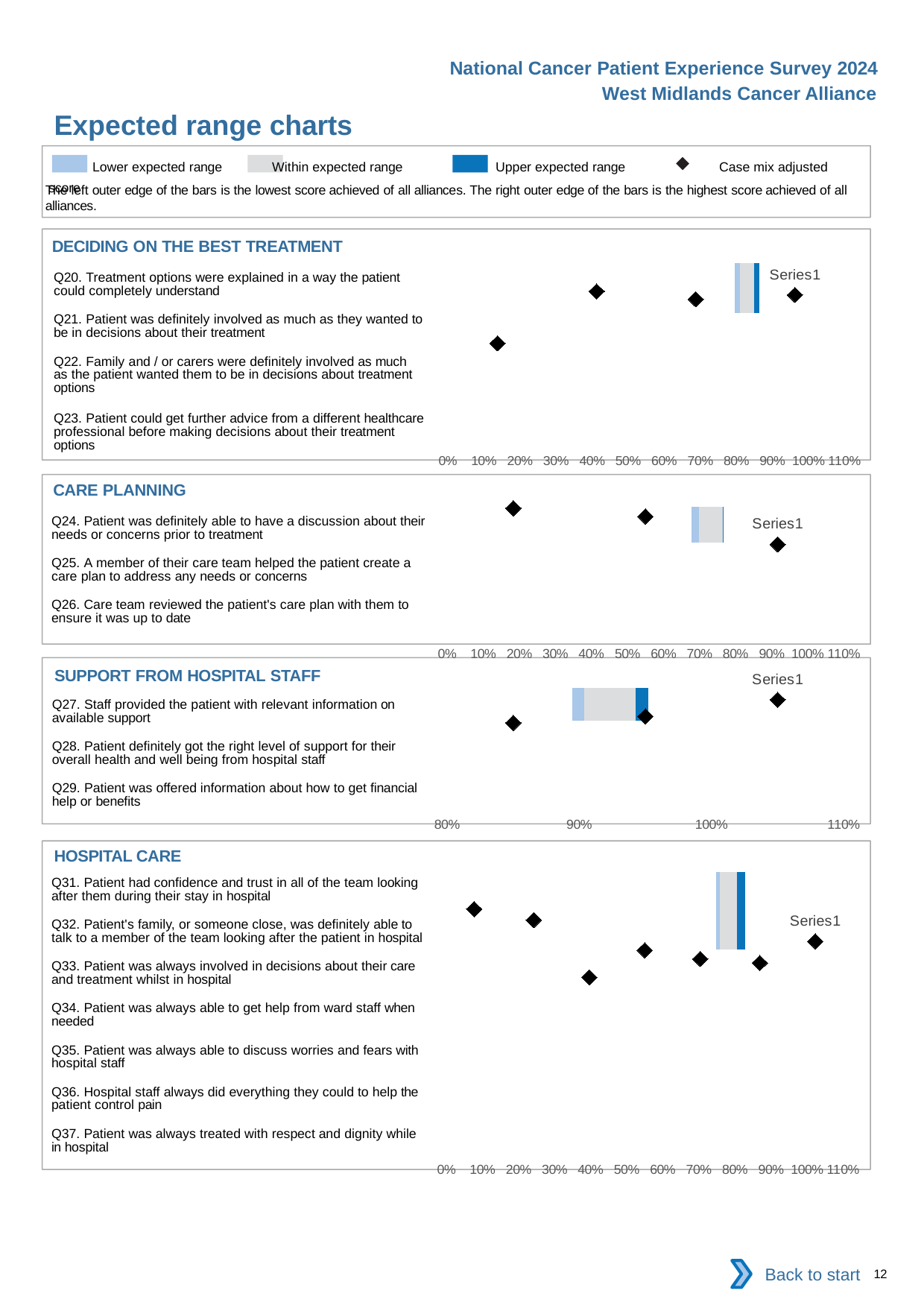
How many diamond markers are plotted in the Support from hospital staff chart? 3 How many diamond markers are plotted in the Hospital care chart? 7 How many series does the legend of the Hospital care chart list? 1 What are the lowest and highest tick labels on the x axis of the Support from hospital staff chart? 80% and 110% What is the legend entry shown in the Care planning chart? Series1 In the Care planning chart, is the rightmost diamond marker greater or less than 80%? greater How many diamond markers are plotted in the Care planning chart? 3 In the Support from hospital staff chart, is the rightmost diamond marker greater or less than 100%? greater In the Deciding on the best treatment chart, is the leftmost diamond marker greater or less than 30%? less